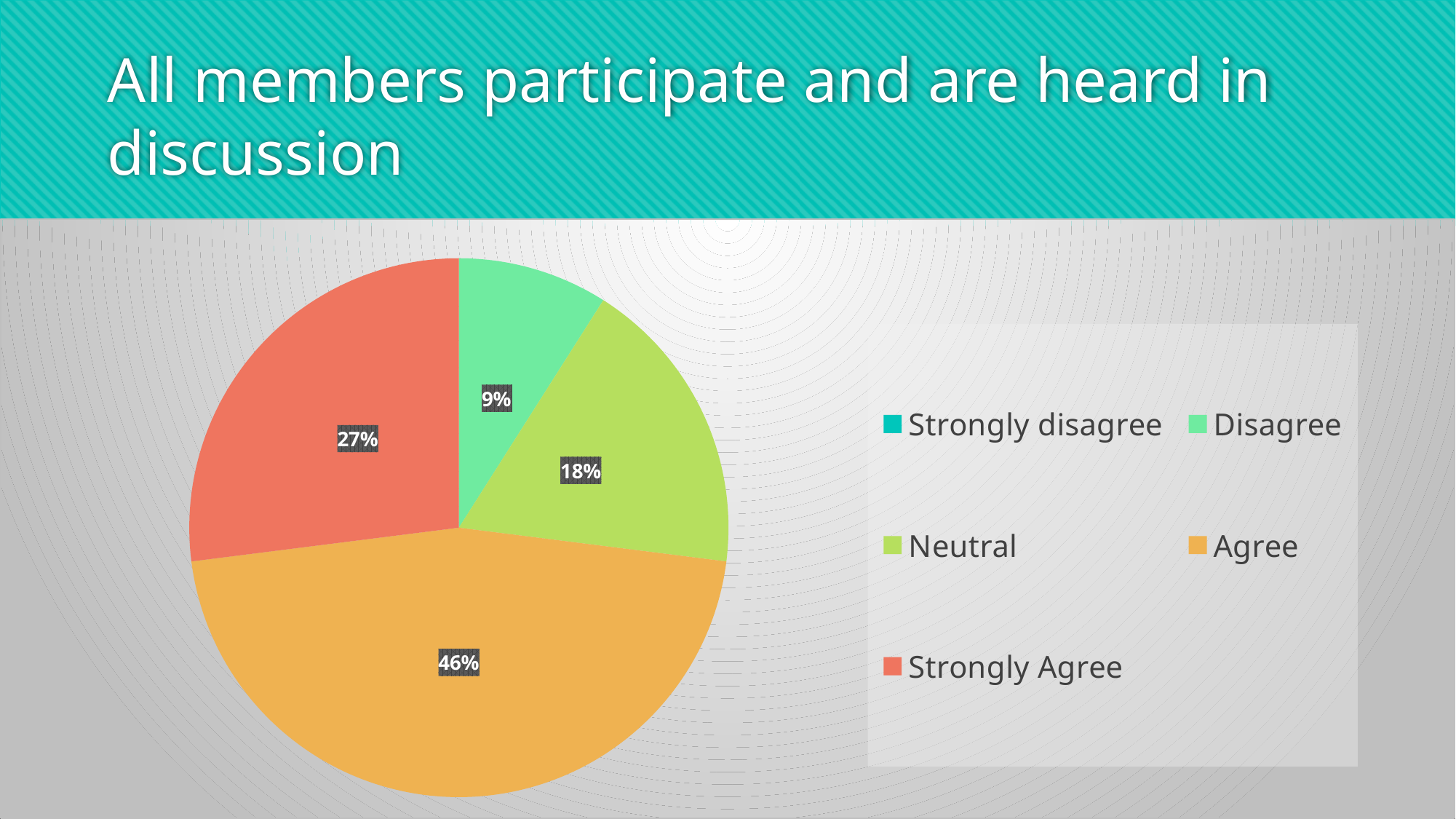
What is the combined percentage of Agree and Strongly Agree? 73% What percentage of respondents chose Neutral? 18% What is the title of the chart on the slide? All members participate and are heard in discussion Which response category has the largest slice of the pie? Agree Which is larger, the Neutral slice or the Disagree slice? Neutral How many entries does the legend list? 5 What percentage of respondents chose Disagree? 9% What percentage of respondents chose Agree? 46% Which labelled slice of the pie is the smallest? Disagree What percentage of respondents chose Strongly Agree? 27% What is the difference in percentage points between Agree and Strongly Agree? 19 What type of chart is shown on the slide? pie chart